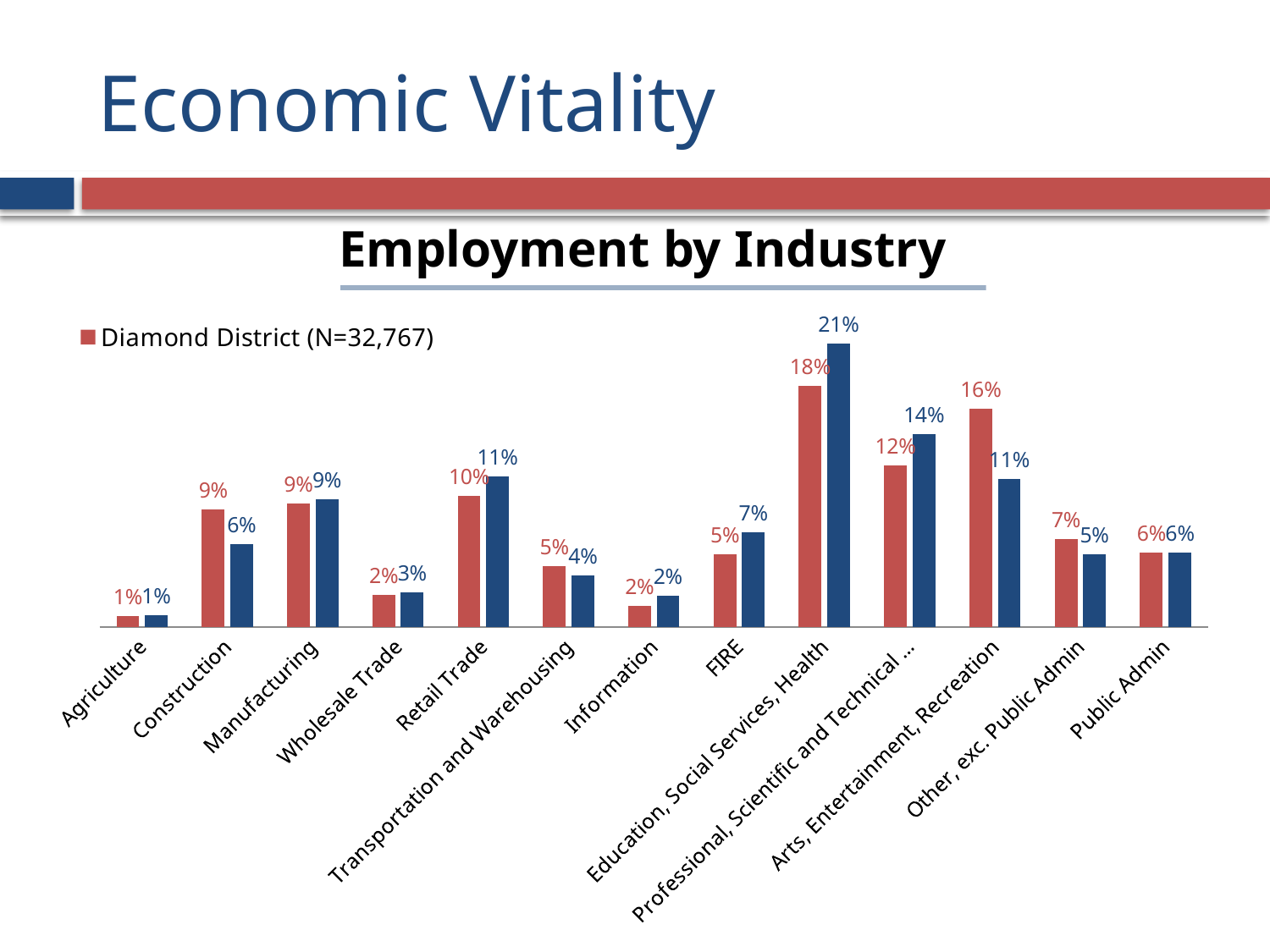
What is the Diamond District value for Retail Trade? 10% What is the Diamond District value for Arts, Entertainment, Recreation? 16% Which industry has the highest Diamond District value? Education, Social Services, Health For the Diamond District, which is larger: Construction or FIRE? Construction What is the Diamond District value for Information? 2% What is the difference between the Diamond District values for Arts, Entertainment, Recreation and Other, exc. Public Admin? 9% What kind of chart is shown on the slide? Bar chart What is the Diamond District value for Public Admin? 6% Which industry has the lowest Diamond District value? Agriculture How many industry categories are shown on the x axis? 13 What is the difference between the Diamond District values for Education, Social Services, Health and Arts, Entertainment, Recreation? 2% What is the title of the chart? Employment by Industry